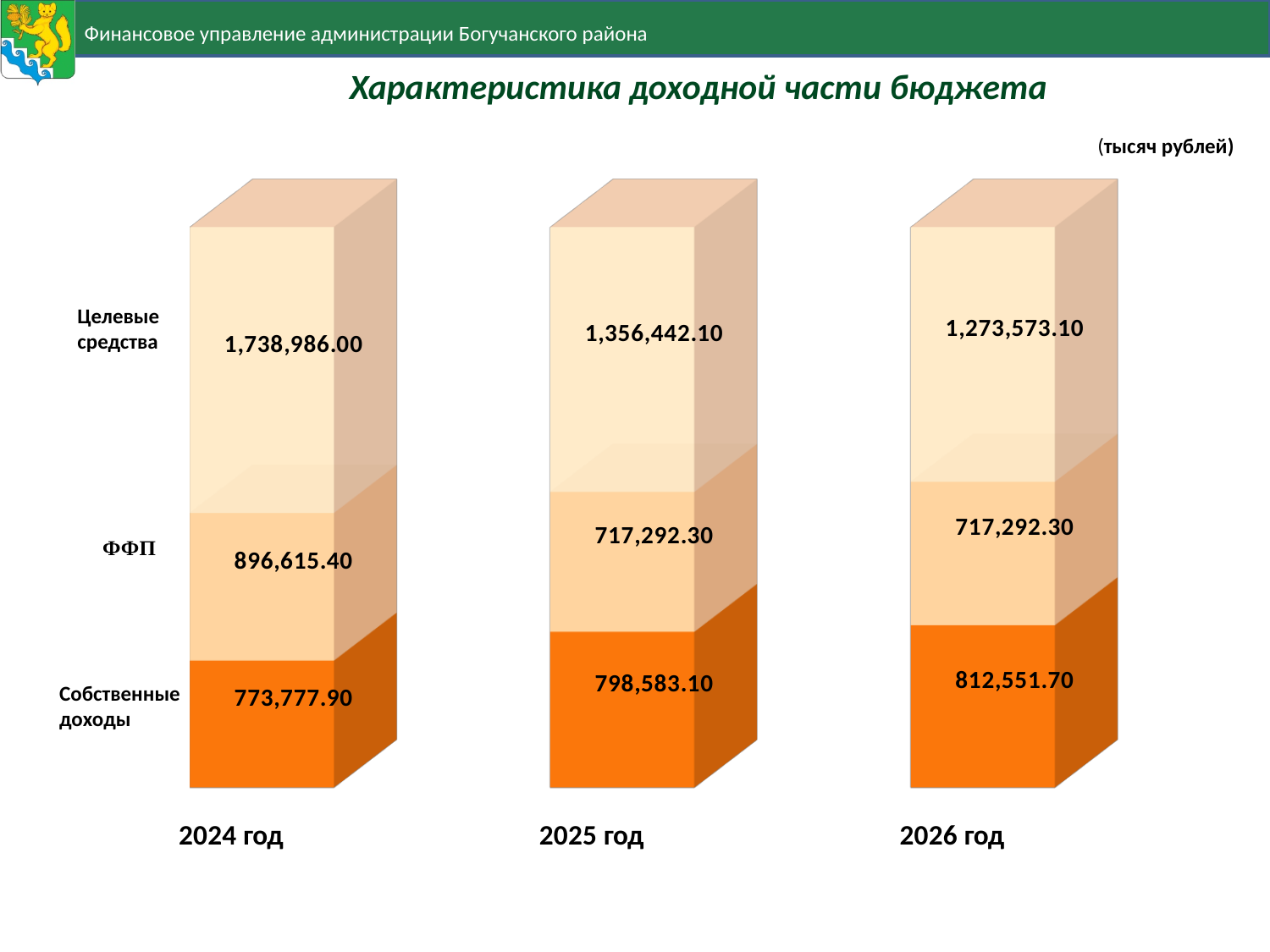
What is the value of Целевые средства for 2024 год? 1,738,986.00 Which is larger: Собственные доходы in 2025 год or in 2026 год? 2026 год In which year is Целевые средства the highest? 2024 год Do the values of Собственные доходы rise or fall from 2024 год to 2026 год? Rise What is the value of ФФП for 2025 год? 717,292.30 How many years (categories) are shown on the chart? 3 What type of chart is shown on the slide? Stacked bar chart In which year is Собственные доходы the lowest? 2024 год How many series (income components) are shown in each bar? 3 What is the difference between Целевые средства in 2024 год and 2025 год? 382,543.90 What is the total of the stacked bar for 2025 год? 2,872,317.50 What is the value of Собственные доходы for 2026 год? 812,551.70